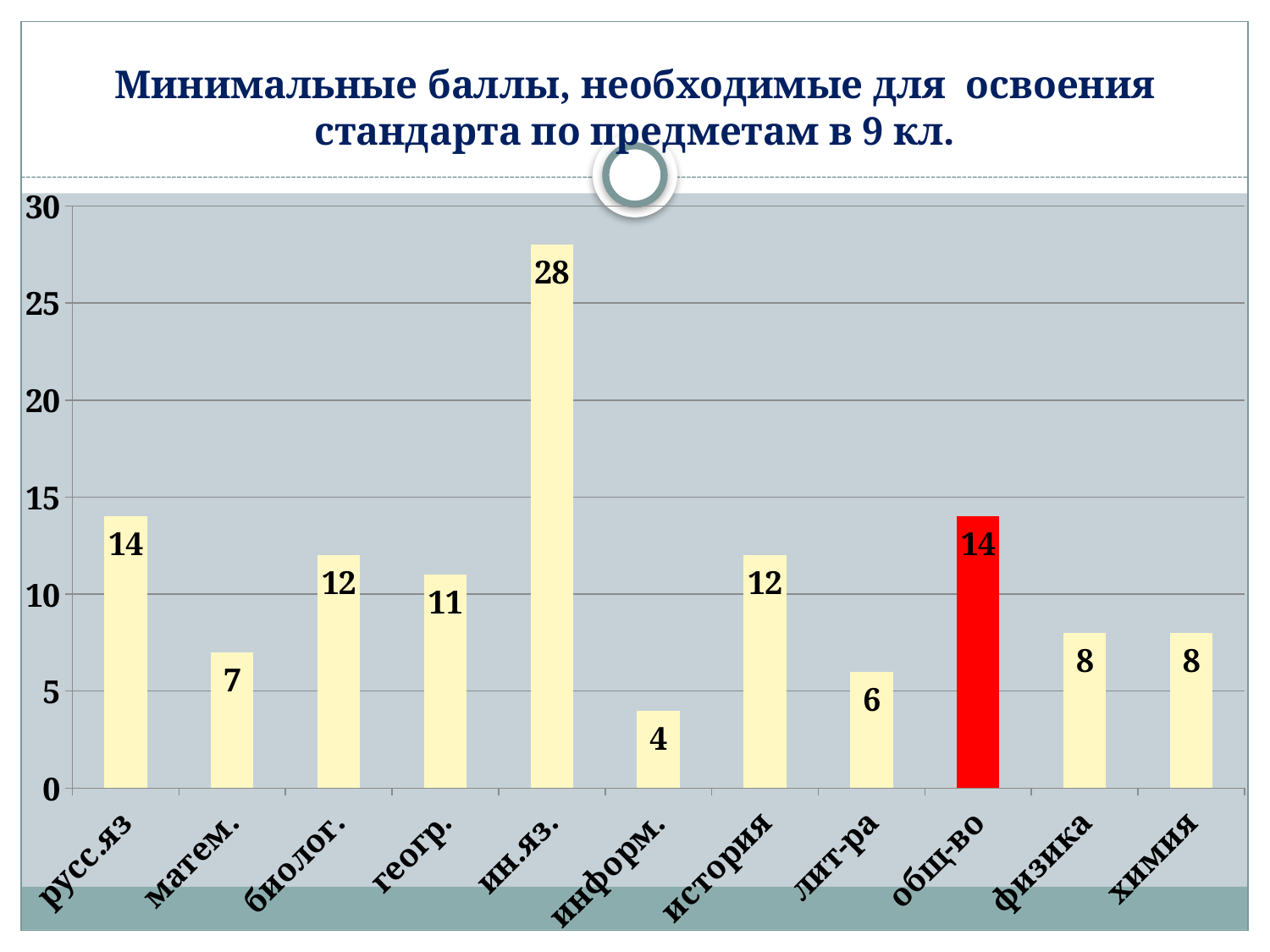
What is the value for геогр.? 11 What is the difference between the values for биолог. and матем.? 5 What is the value for лит-ра? 6 What is the difference between the values for ин.яз. and русс.яз? 14 Which category has the lowest value? информ. Which is larger, the value for история or the value for физика? история Which category has the highest value? ин.яз. How many categories are shown on the x axis? 11 What is the value for информ.? 4 Which category's bar is coloured red? общ-во What is the value for ин.яз.? 28 What kind of chart is this? bar chart